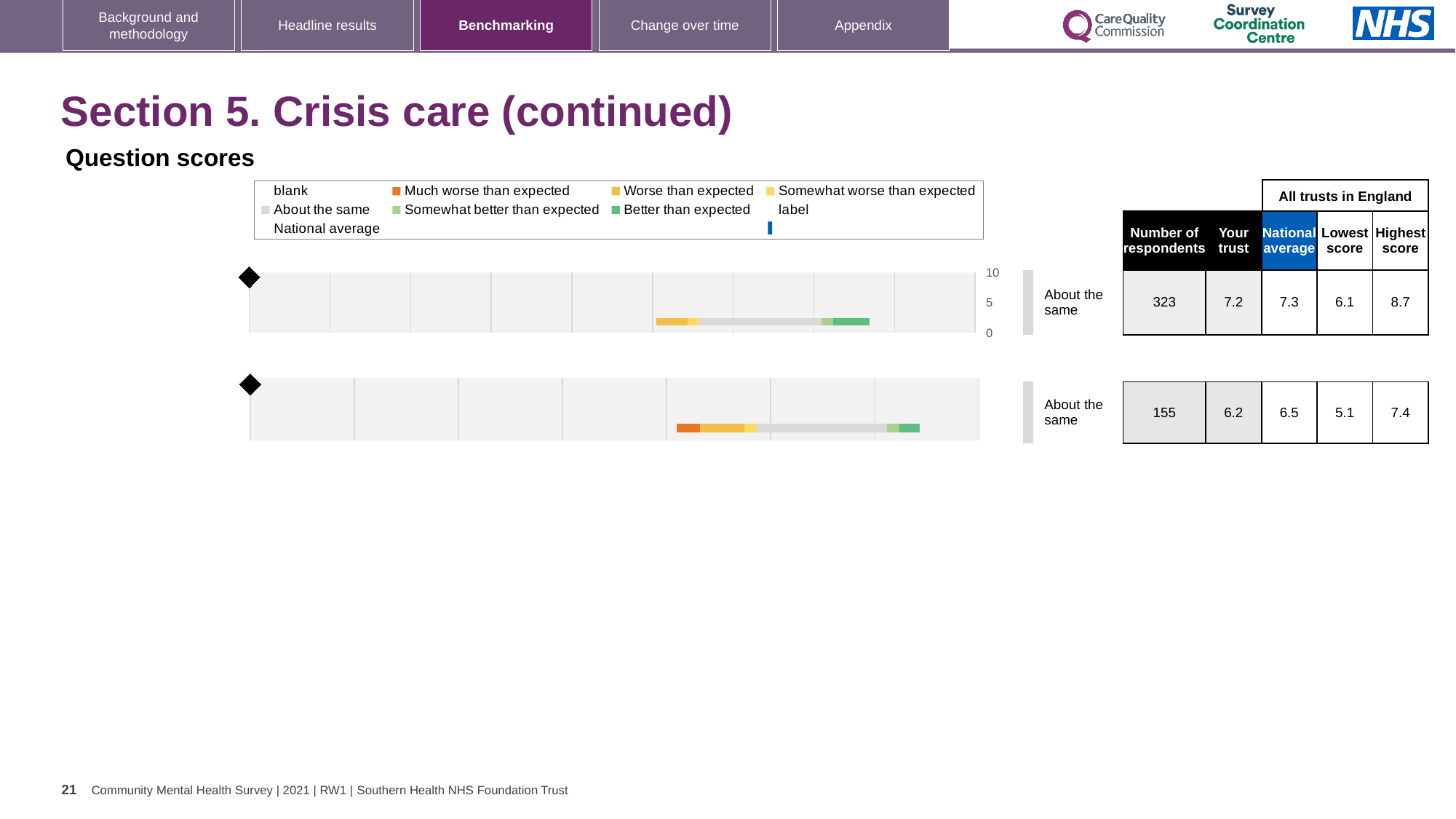
In the bottom chart, what is the 'Your trust' score? 6.2 In the top chart, how many respondents are shown in the table? 323 In the top chart, what is the highest score among all trusts in England? 8.7 Which chart has the higher 'Your trust' score, the top chart or the bottom chart? Top chart In the bottom chart, how many respondents are shown in the table? 155 In the bottom chart, what is the lowest score among all trusts in England? 5.1 In the top chart, what is the national average score? 7.3 In the top chart, what is the difference between the highest score and the lowest score among all trusts in England? 2.6 What benchmark category is the trust placed in for the bottom chart? About the same In the bottom chart, what is the difference between the national average and the 'Your trust' score? 0.3 In the top chart, what is the 'Your trust' score? 7.2 What colour does the legend use for 'Much worse than expected'? Orange